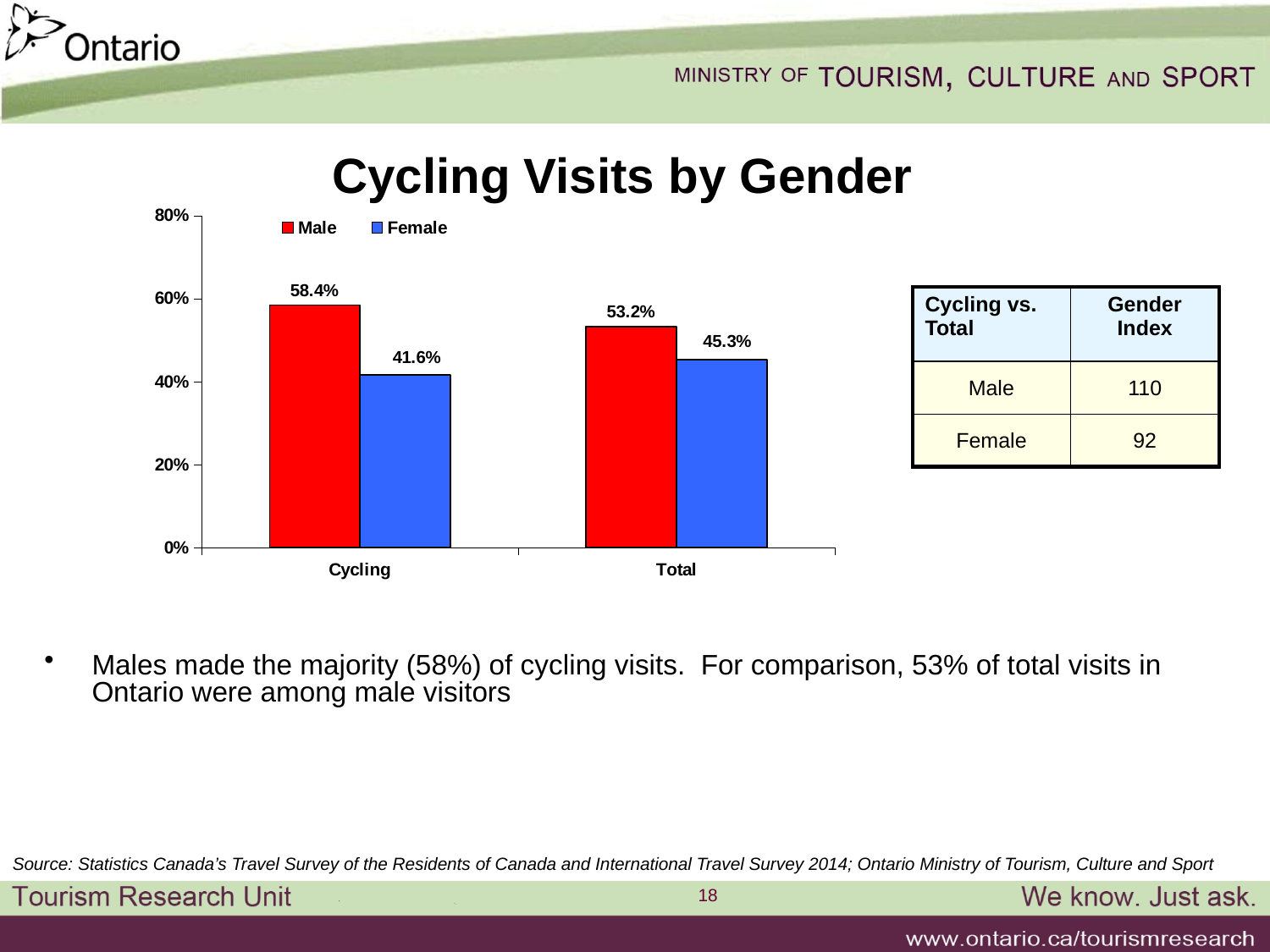
What is the Male value for Total? 53.2% How many categories are shown on the x axis? 2 Is the Female value for Total larger or smaller than the Female value for Cycling? larger How many series does the legend list? 2 What is the Female value for Cycling? 41.6% What is the Female value for Total? 45.3% Which series has the highest value in the Cycling category? Male What is the difference between the Male and Female values for Cycling? 16.8% What is the Male value for Cycling? 58.4% Which bar has the lowest value on the chart? Female, Cycling What kind of chart is shown on the slide? bar chart What is the difference between the Male value for Cycling and the Male value for Total? 5.2%